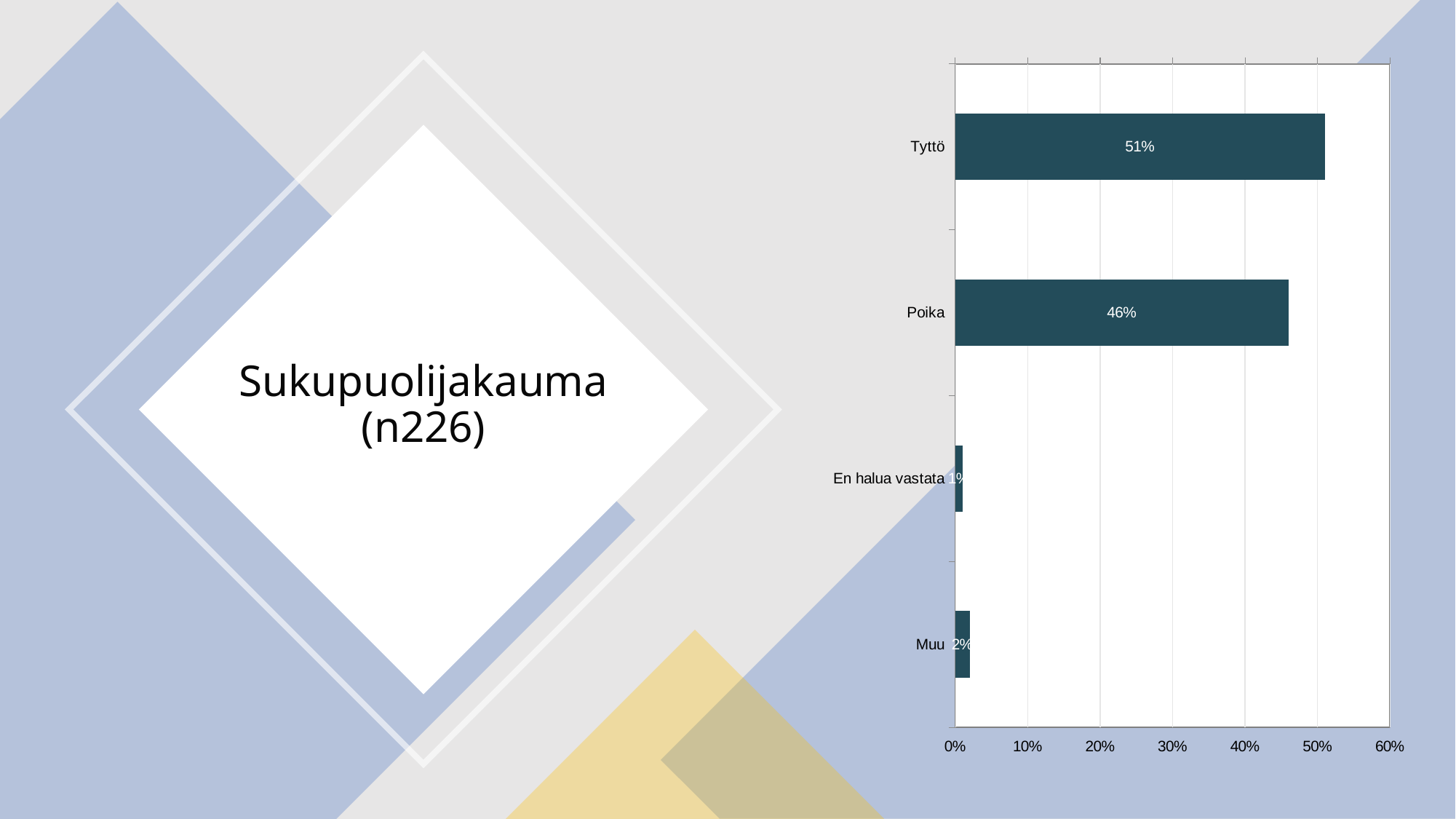
Which category has the highest value? Tyttö Which category has the lowest value? En halua vastata What is the value for Muu? 2% What is the value for Tyttö? 51% What is the difference between the values for Tyttö and Poika? 5% How many categories are shown in the chart? 4 What is the value for Poika? 46% Is the value for Poika greater or less than 50%? less What is the title text shown on the slide next to the chart? Sukupuolijakauma (n226) Which is larger, the value for Muu or the value for En halua vastata? Muu What kind of chart is shown on the slide? bar chart What is the value for En halua vastata? 1%